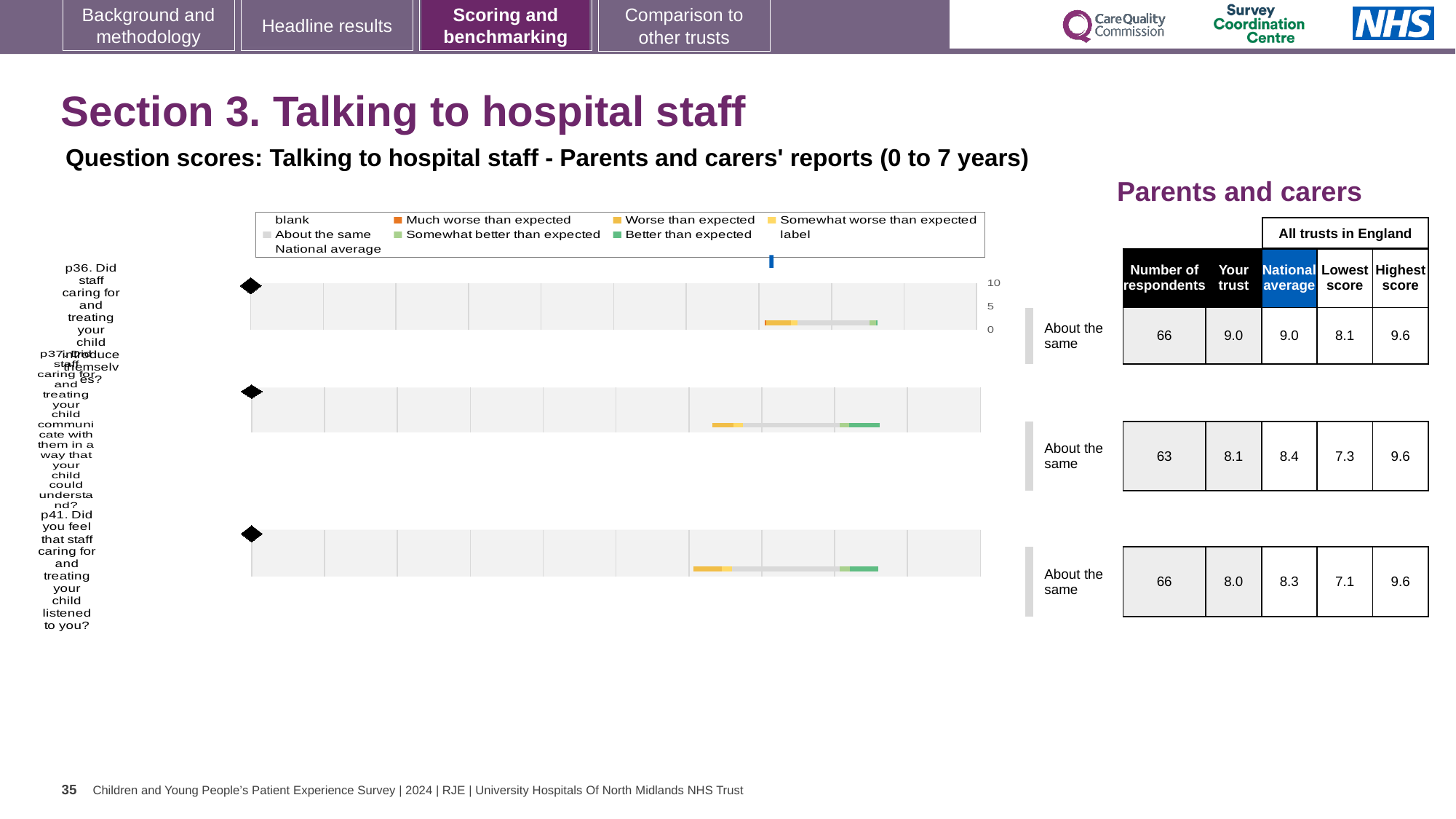
What benchmark category is shown for each of the three questions? About the same What is the 'Your trust' score for question p36? 9.0 Is the 'Your trust' score for p37 higher or lower than the national average for p37? lower What is the difference between the national average and the 'Your trust' score for question p41? 0.3 How many questions are plotted on the slide? 3 What is the national average score for question p37? 8.4 What is the lowest score across all trusts in England for question p36? 8.1 What kind of chart is used to show the question scores? bar chart What is the highest score across all trusts in England for question p41? 9.6 How many respondents answered question p41? 66 Which question has the highest 'Your trust' score: p36, p37 or p41? p36 Which question has the lowest 'Your trust' score: p36, p37 or p41? p41